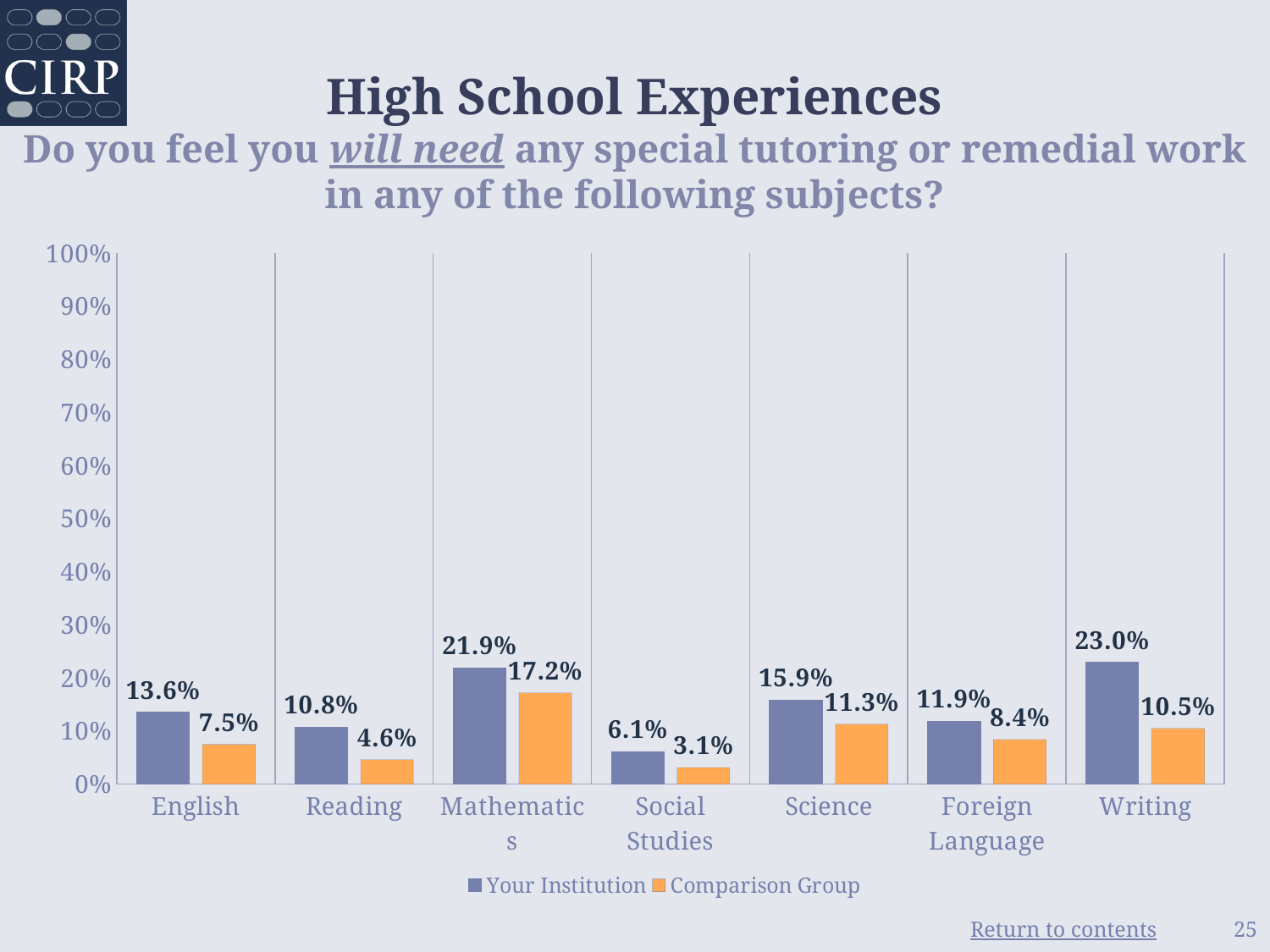
What is the difference between Your Institution and the Comparison Group for Writing? 12.5% Which subject has the lowest value for the Comparison Group? Social Studies Is the value for Your Institution in Mathematics greater or less than 20%? greater How many subjects are shown on the x axis? 7 What is the difference between Your Institution and the Comparison Group for English? 6.1% What kind of chart is shown on the slide? Bar chart What is the value for Your Institution in Mathematics? 21.9% What is the value for Your Institution in Social Studies? 6.1% Which is larger for Science: Your Institution or the Comparison Group? Your Institution Which subject has the highest value for Your Institution? Writing How many series does the legend list? 2 What is the value for the Comparison Group in Writing? 10.5%